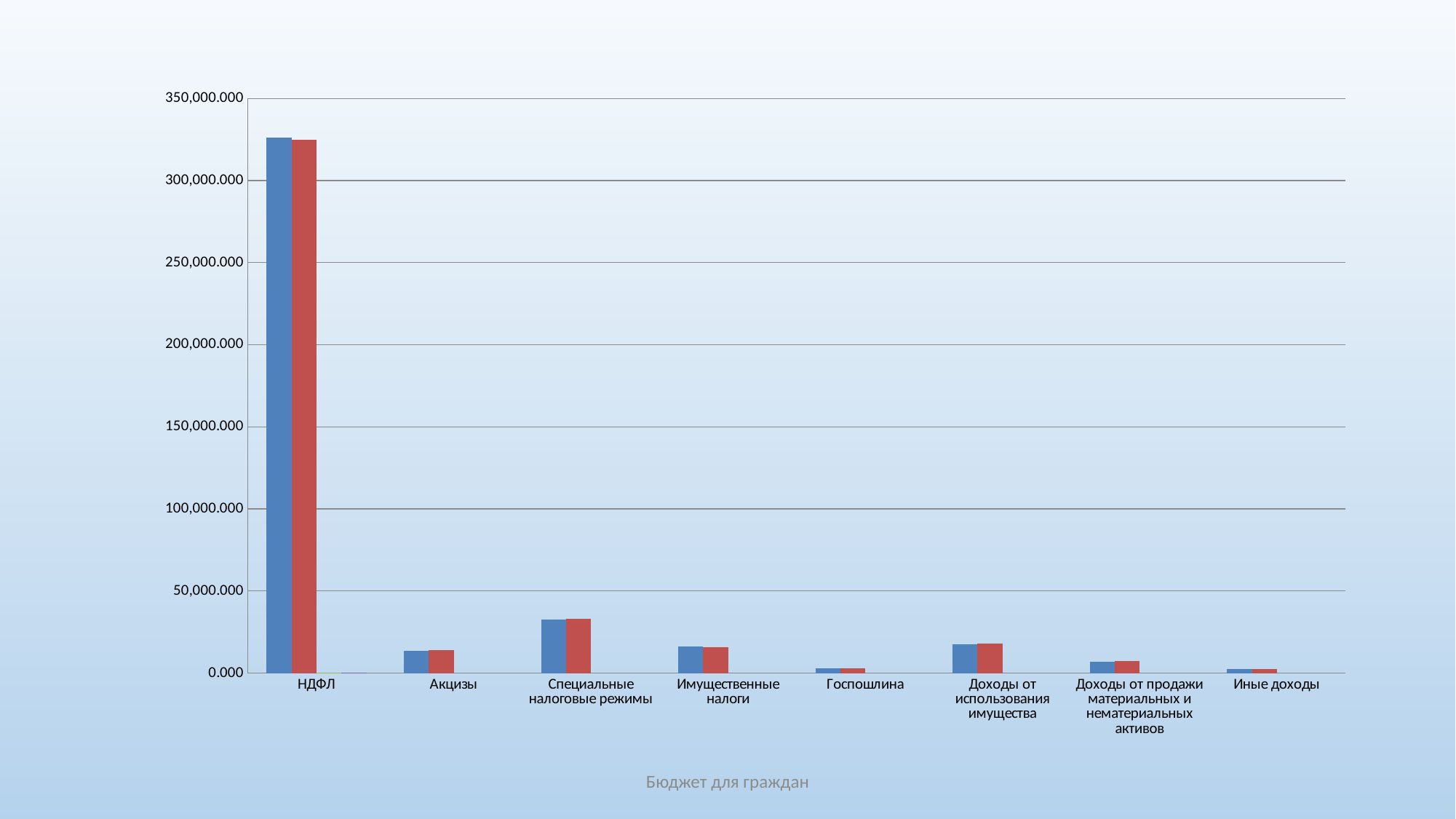
What text appears below the chart on the slide? Бюджет для граждан Which has the taller blue bar: Имущественные налоги or Госпошлина? Имущественные налоги Is the blue bar for НДФЛ greater or less than 300,000.000? greater Which has the taller red bar: Специальные налоговые режимы or Доходы от использования имущества? Специальные налоговые режимы Which category has the highest bars in the chart? НДФЛ Which has the taller blue bar: Специальные налоговые режимы or Акцизы? Специальные налоговые режимы Is the blue bar for Доходы от использования имущества greater or less than 100,000.000? less What is the highest value labelled on the vertical axis of the chart? 350,000.000 What kind of chart is shown on the slide? bar chart Is the blue bar for Специальные налоговые режимы greater or less than 50,000.000? less How many categories are shown along the x axis of the chart? 8